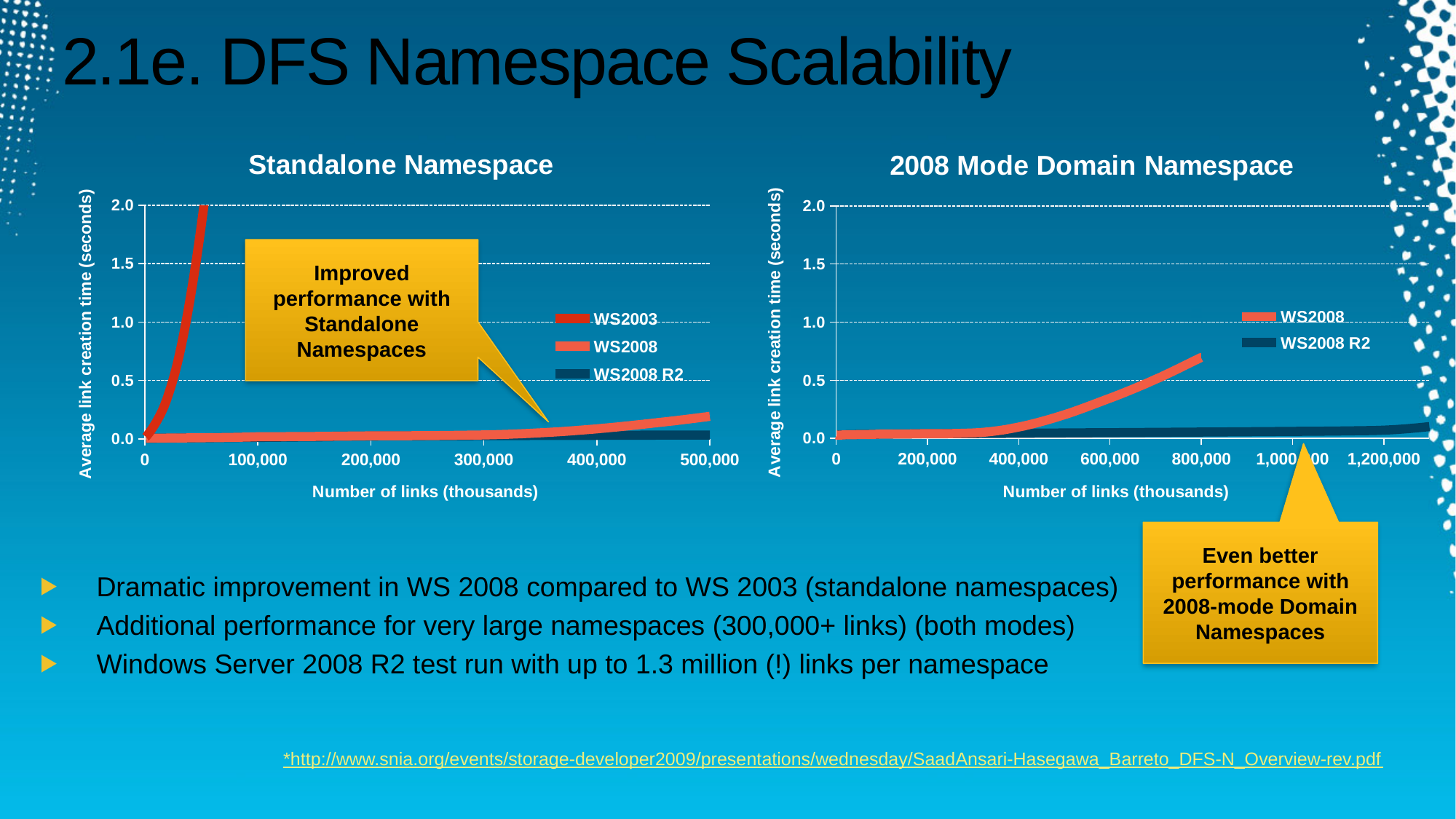
What is the y-axis label of the 2008 Mode Domain Namespace chart? Average link creation time (seconds) In the 2008 Mode Domain Namespace chart, does the WS2008 line rise or fall as the number of links increases? rise In the Standalone Namespace chart, which series is shown in red? WS2003 In the 2008 Mode Domain Namespace chart, is the WS2008 value at 800,000 links greater or less than 0.5? greater How many series does the legend of the Standalone Namespace chart list? 3 In the 2008 Mode Domain Namespace chart, which series has the higher value at 800,000 links, WS2008 or WS2008 R2? WS2008 In the 2008 Mode Domain Namespace chart, is the WS2008 R2 value at 1,200,000 links greater or less than 0.5? less In the Standalone Namespace chart, is the WS2008 value at 500,000 links greater or less than 0.5? less In the Standalone Namespace chart, which series has the higher value at 500,000 links, WS2008 or WS2008 R2? WS2008 How many series does the legend of the 2008 Mode Domain Namespace chart list? 2 What kind of chart is the Standalone Namespace chart? line chart